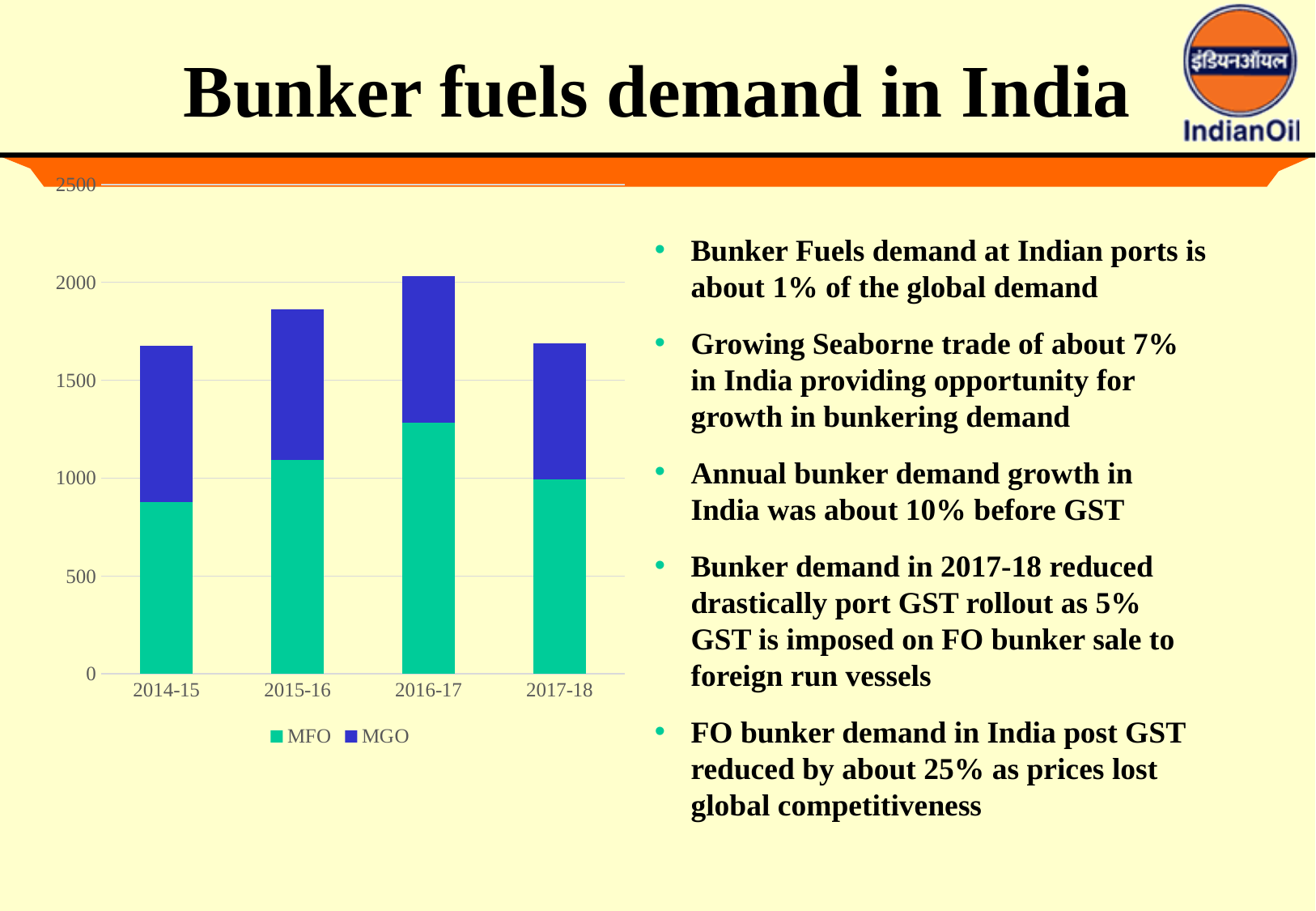
Which is larger, the MFO value for 2016-17 or the MFO value for 2015-16? 2016-17 Which year has the lowest MFO value in the chart? 2014-15 Is the MFO value for 2014-15 greater or less than 1000? less How many year categories are shown on the x axis of the chart? 4 Is the total stacked bar for 2015-16 greater or less than 2000? less Which colour represents the MFO series in the chart's legend? Teal (green) Is the MFO value for 2015-16 greater or less than 1000? greater Which year has the highest MFO value in the chart? 2016-17 How many series does the chart's legend list? 2 Which year has the highest total stacked bar in the chart? 2016-17 What kind of chart is shown on the slide? Stacked bar chart